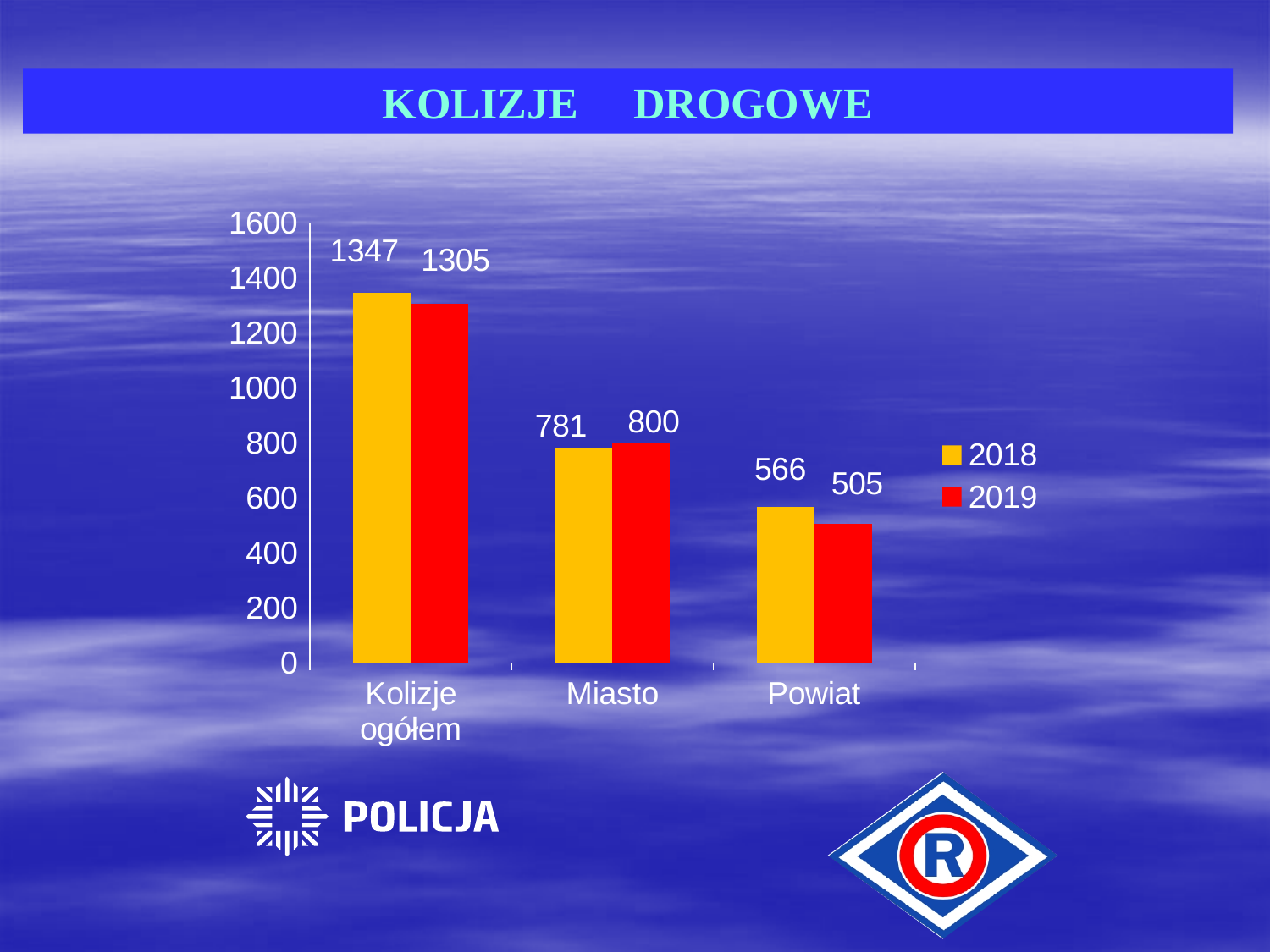
Which is larger for Miasto, the 2018 value or the 2019 value? 2019 What is the difference between the 2018 and 2019 values for Powiat? 61 What kind of chart is shown on the slide? bar chart What is the value for Miasto in 2019? 800 How many categories are shown on the x axis? 3 What is the value for Powiat in 2018? 566 Which category has the lowest value in 2019? Powiat What is the difference between the 2018 and 2019 values for Kolizje ogółem? 42 Which category has the highest value in 2018? Kolizje ogółem What is the value for Kolizje ogółem in 2018? 1347 Is the 2019 value for Powiat greater or less than 600? less How many series does the legend list? 2